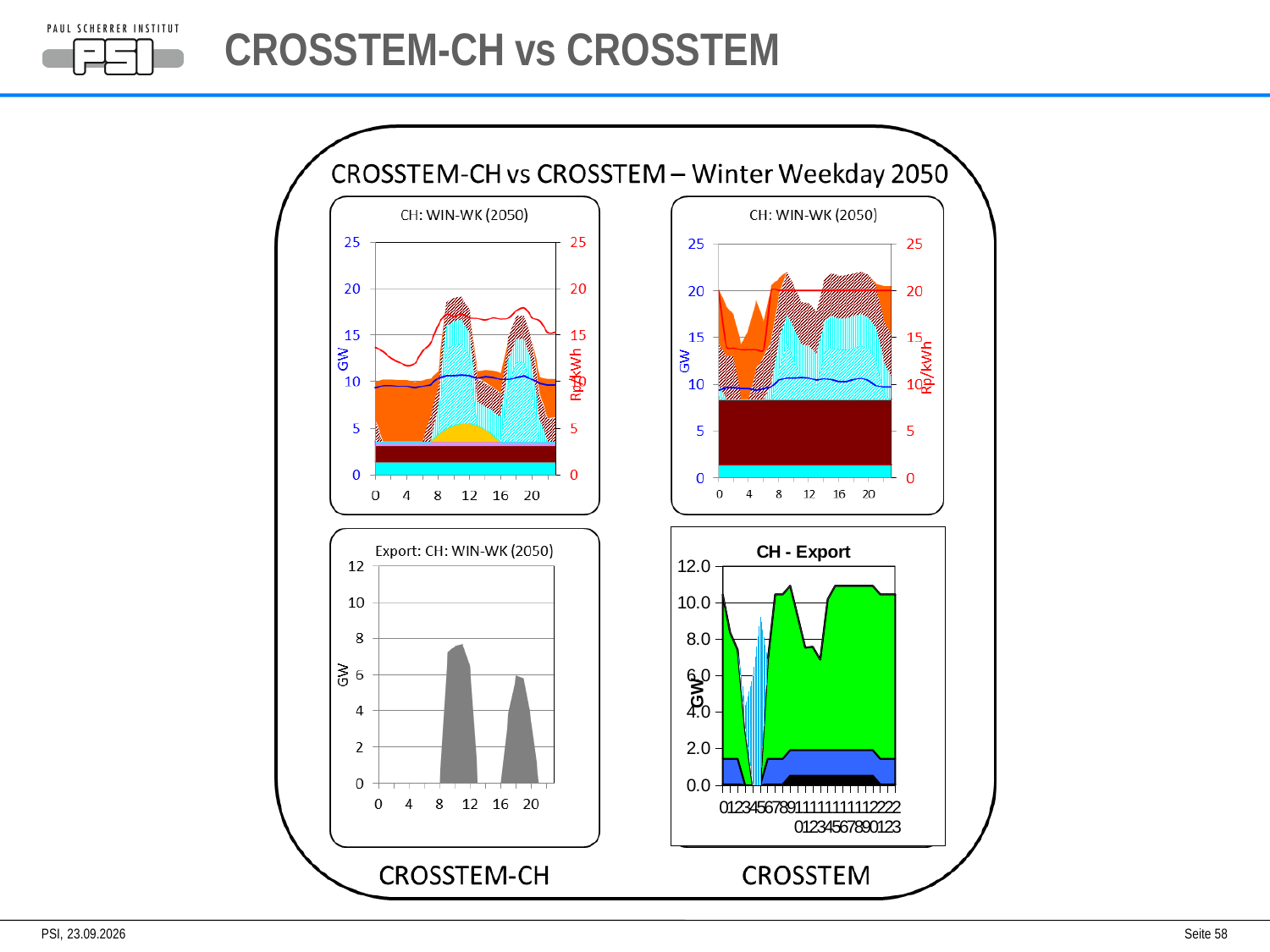
How many charts are shown on the slide? 4 In the top-left chart 'CH: WIN-WK (2050)', is the red line value at hour 12 greater or less than 15? greater In the top-right chart 'CH: WIN-WK (2050)', is the blue line value at hour 12 greater or less than 15? less In the top-left chart 'CH: WIN-WK (2050)', what is the label of the left y axis? GW In the bottom-left chart 'Export: CH: WIN-WK (2050)', is the export value at hour 4 greater or less than 2? less In the top-left chart 'CH: WIN-WK (2050)', what is the maximum value shown on the left y axis? 25 What kind of chart is the bottom-left chart titled 'Export: CH: WIN-WK (2050)'? area chart In the bottom-left chart 'Export: CH: WIN-WK (2050)', which peak is higher, the one around hour 11 or the one around hour 19? the one around hour 11 In the bottom-left chart 'Export: CH: WIN-WK (2050)', what is the highest value shown on the y axis? 12 What is the title of the bottom-right chart? CH - Export